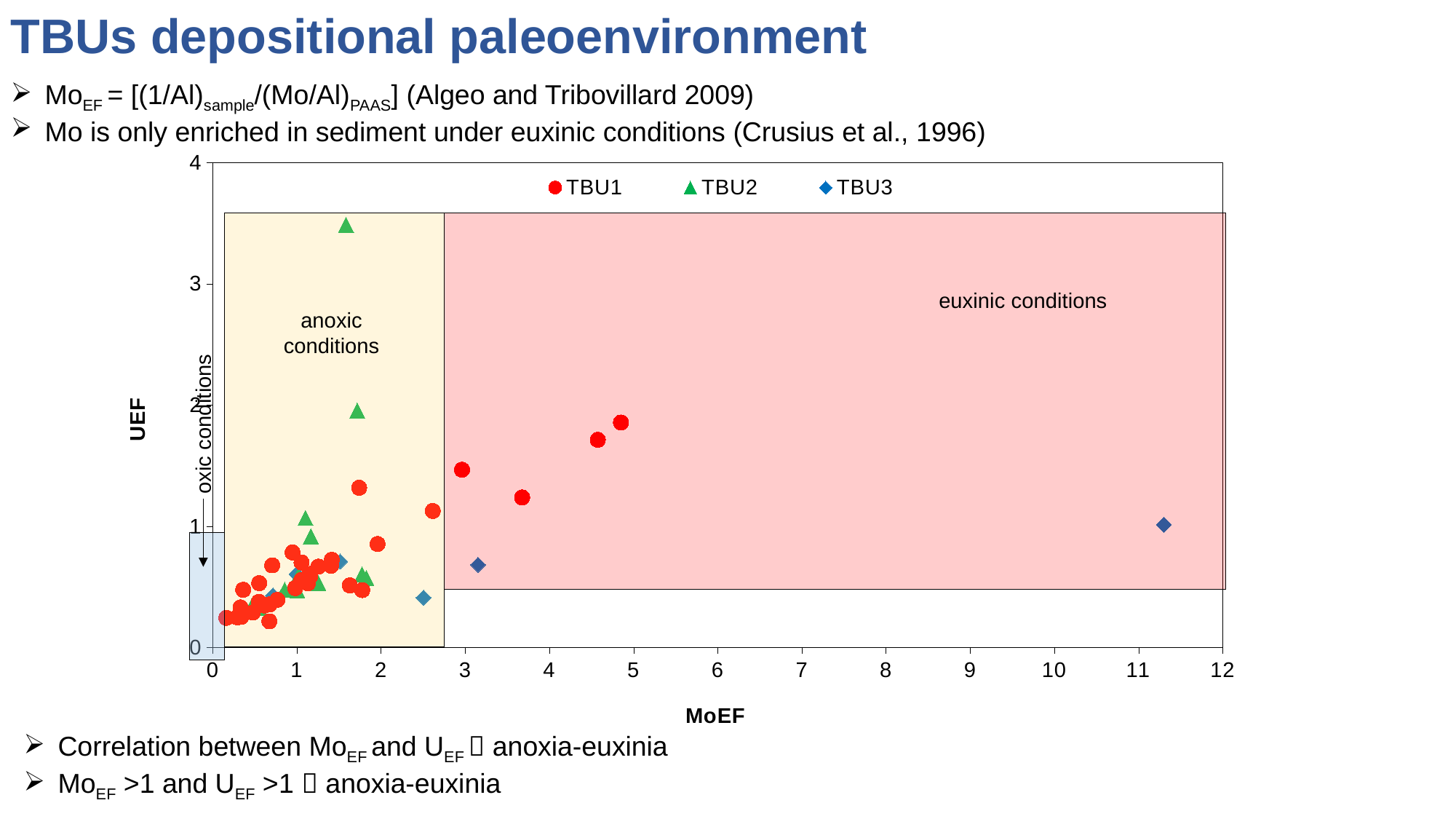
What are the names of the series listed in the chart legend? TBU1, TBU2, TBU3 Is the MoEF value of the rightmost TBU1 point greater or less than 4? greater What kind of chart is shown on the slide? scatter chart Which series contains the point with the highest MoEF value? TBU3 How many series does the chart legend list? 3 Is the UEF value of the highest TBU2 point greater or less than 3? greater What is the maximum value shown on the x axis of the chart? 12 Which series contains the point with the highest UEF value? TBU2 What is the title of the x axis of the chart? MoEF Which is larger: the highest MoEF value among TBU1 points or the highest MoEF value among TBU3 points? TBU3 Is the MoEF value of the rightmost TBU1 point greater or less than 5? less